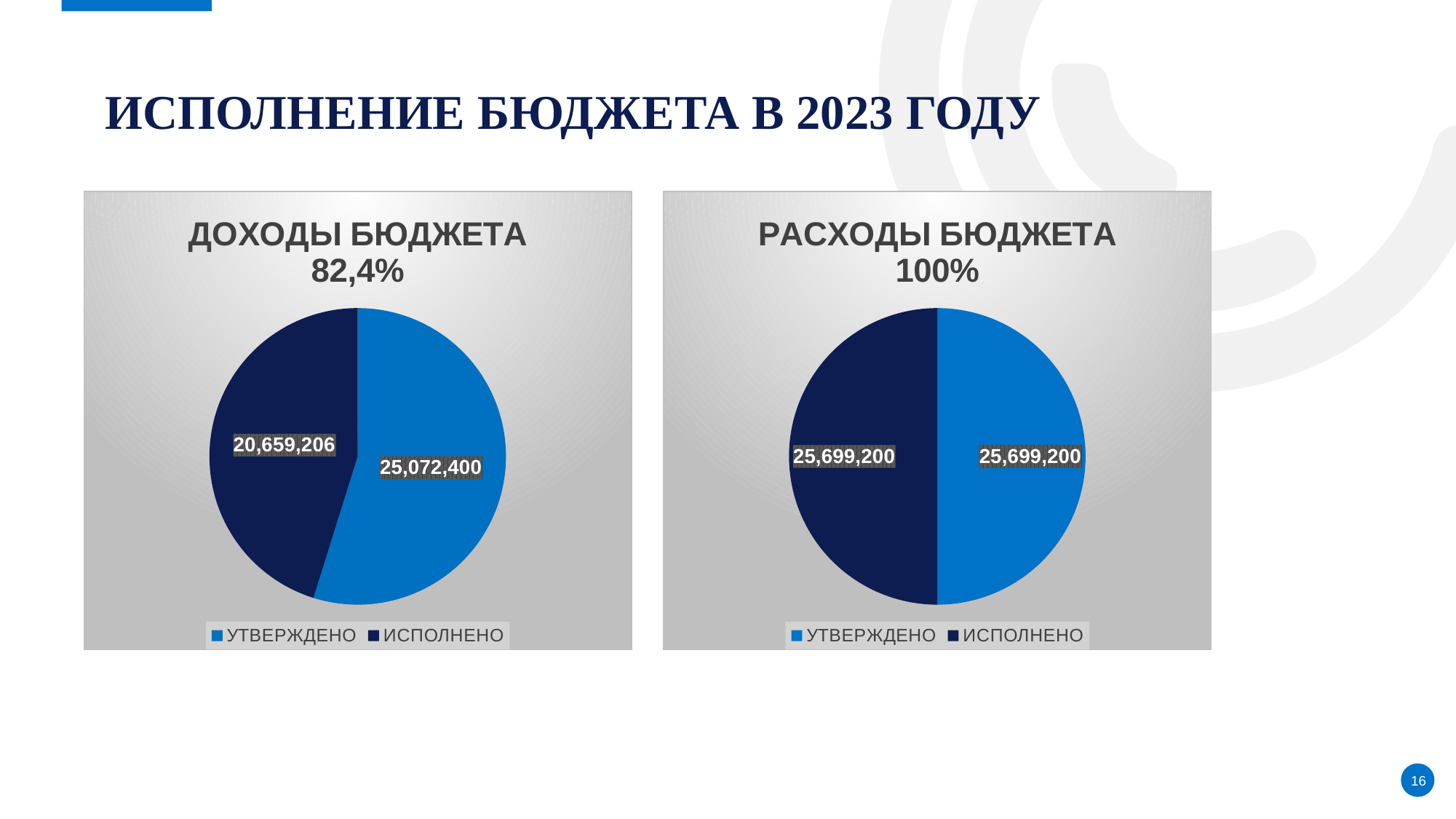
What execution percentage is shown in the title of the ДОХОДЫ БЮДЖЕТА chart? 82,4% How many entries does the legend of the ДОХОДЫ БЮДЖЕТА chart list? 2 On the ДОХОДЫ БЮДЖЕТА chart, which slice is larger, УТВЕРЖДЕНО or ИСПОЛНЕНО? УТВЕРЖДЕНО On the ДОХОДЫ БЮДЖЕТА chart, what is the value for УТВЕРЖДЕНО? 25,072,400 On the ДОХОДЫ БЮДЖЕТА chart, what is the difference between УТВЕРЖДЕНО and ИСПОЛНЕНО? 4,413,194 On the РАСХОДЫ БЮДЖЕТА chart, what is the difference between УТВЕРЖДЕНО and ИСПОЛНЕНО? 0 What kind of chart is the ДОХОДЫ БЮДЖЕТА chart? Pie chart How many slices does the РАСХОДЫ БЮДЖЕТА pie chart have? 2 On the РАСХОДЫ БЮДЖЕТА chart, what is the value for УТВЕРЖДЕНО? 25,699,200 On the ДОХОДЫ БЮДЖЕТА chart, which category has the smallest value? ИСПОЛНЕНО On the РАСХОДЫ БЮДЖЕТА chart, what is the value for ИСПОЛНЕНО? 25,699,200 On the ДОХОДЫ БЮДЖЕТА chart, what is the value for ИСПОЛНЕНО? 20,659,206